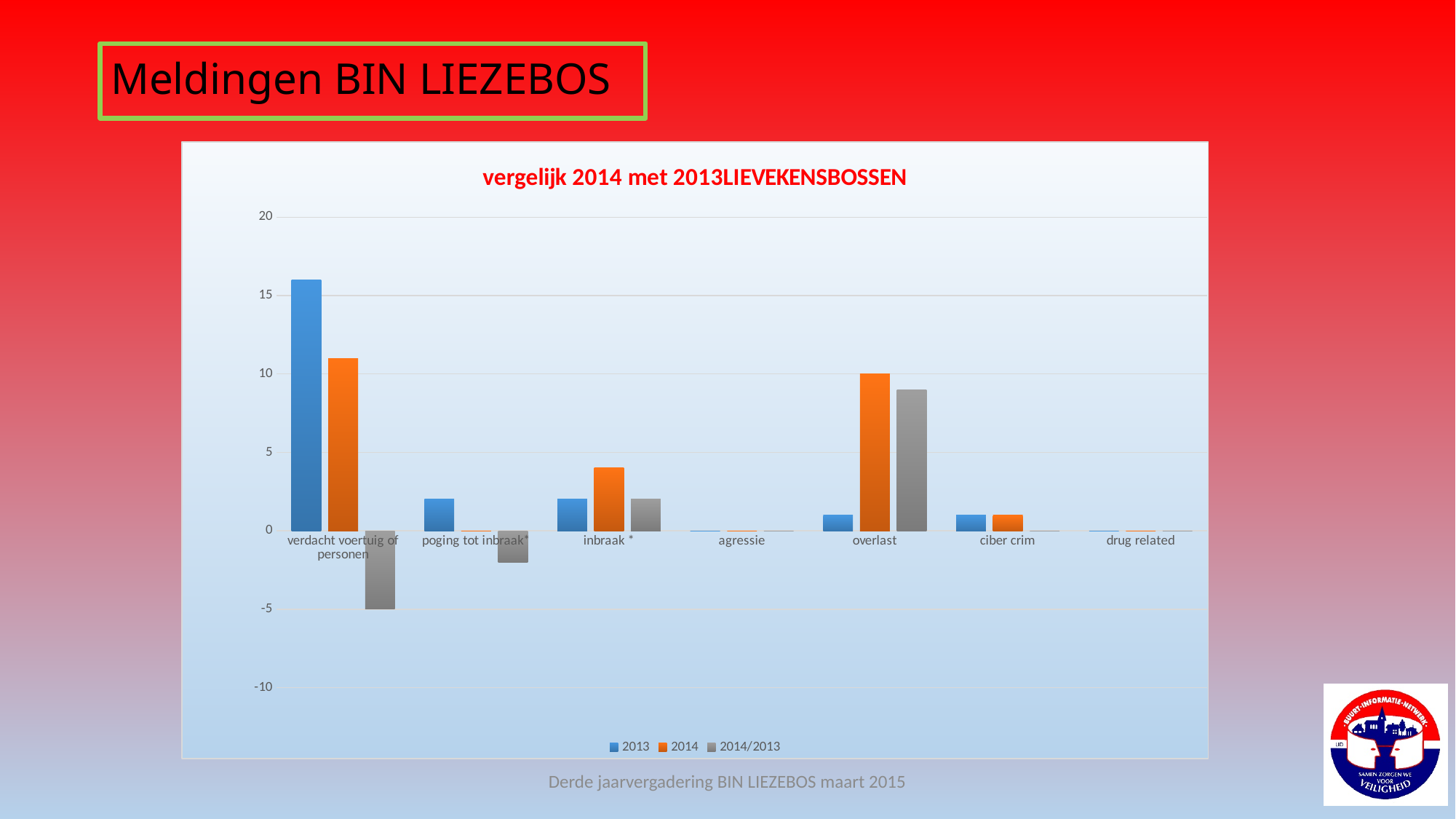
What is the 2014/2013 value for verdacht voertuig of personen? -5 Which category has the highest value for the 2013 series? verdacht voertuig of personen What kind of chart is shown on the slide? bar chart Is the 2013 value for verdacht voertuig of personen greater or less than 15? greater Is the 2014/2013 value for overlast greater or less than 5? greater For inbraak *, which series has the larger value, 2013 or 2014? 2014 What is the 2014 value for overlast? 10 How many series does the legend list? 3 Which category has the lowest value for the 2014/2013 series? verdacht voertuig of personen Which category has the highest value for the 2014/2013 series? overlast How many categories are shown on the x axis? 7 What is the title of the chart? vergelijk 2014 met 2013LIEVEKENSBOSSEN